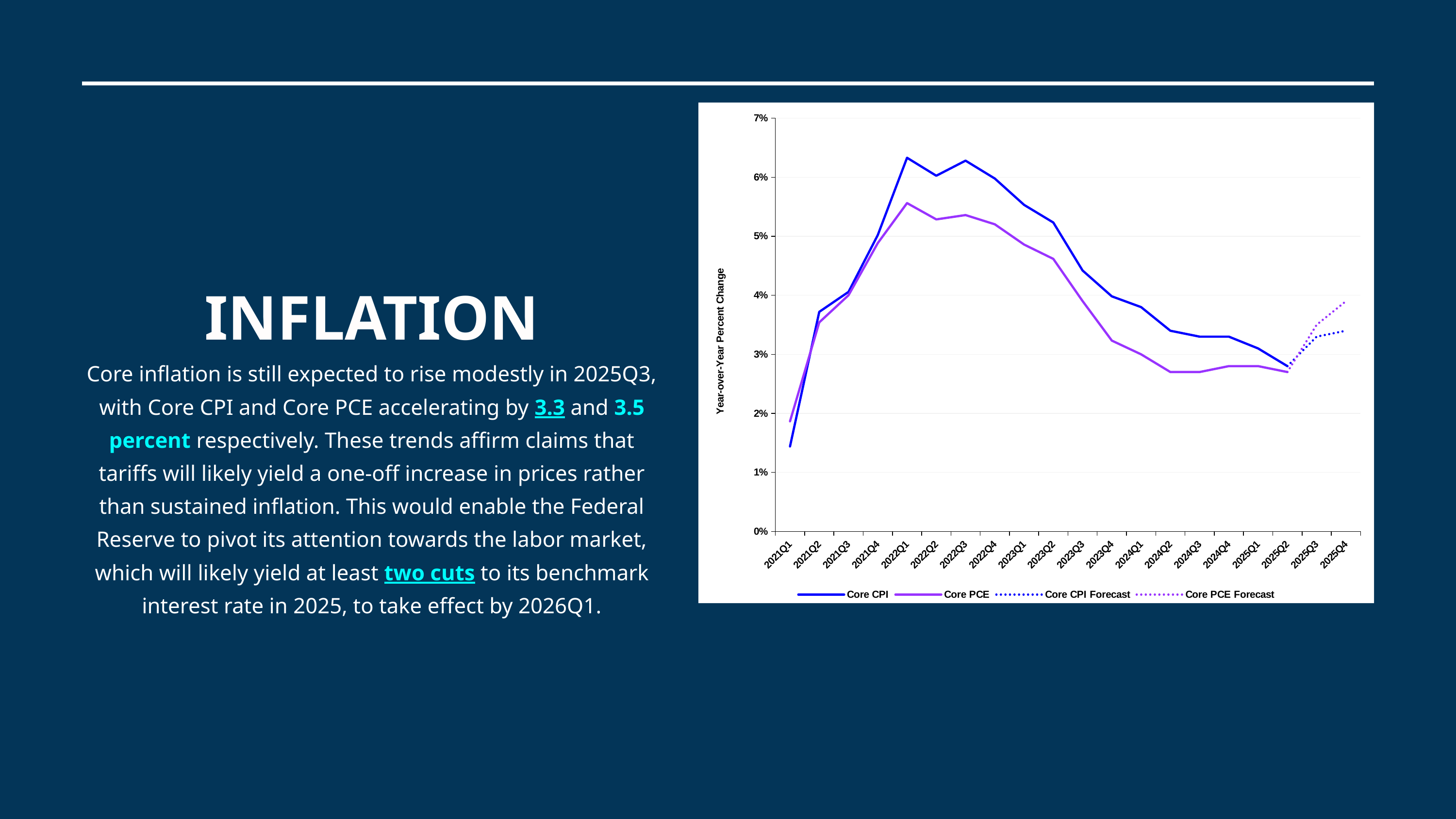
How many quarters are shown along the x axis of the chart? 20 What kind of chart is shown on the slide? line chart Which series in the chart are drawn with dotted lines? Core CPI Forecast and Core PCE Forecast What is the title of the chart's vertical axis? Year-over-Year Percent Change Is the Core PCE Forecast value for 2025Q4 greater or less than 3.5%? greater Is the Core CPI value for 2022Q1 greater or less than 6%? greater Does the Core CPI line rise or fall between 2022Q3 and 2025Q2? fall In which quarter does the Core PCE line reach its highest value? 2022Q1 In which quarter is the Core CPI line at its lowest value? 2021Q1 How many series does the chart's legend list? 4 Is the Core PCE value for 2024Q2 greater or less than 3%? less In 2023Q4, which is larger, Core CPI or Core PCE? Core CPI